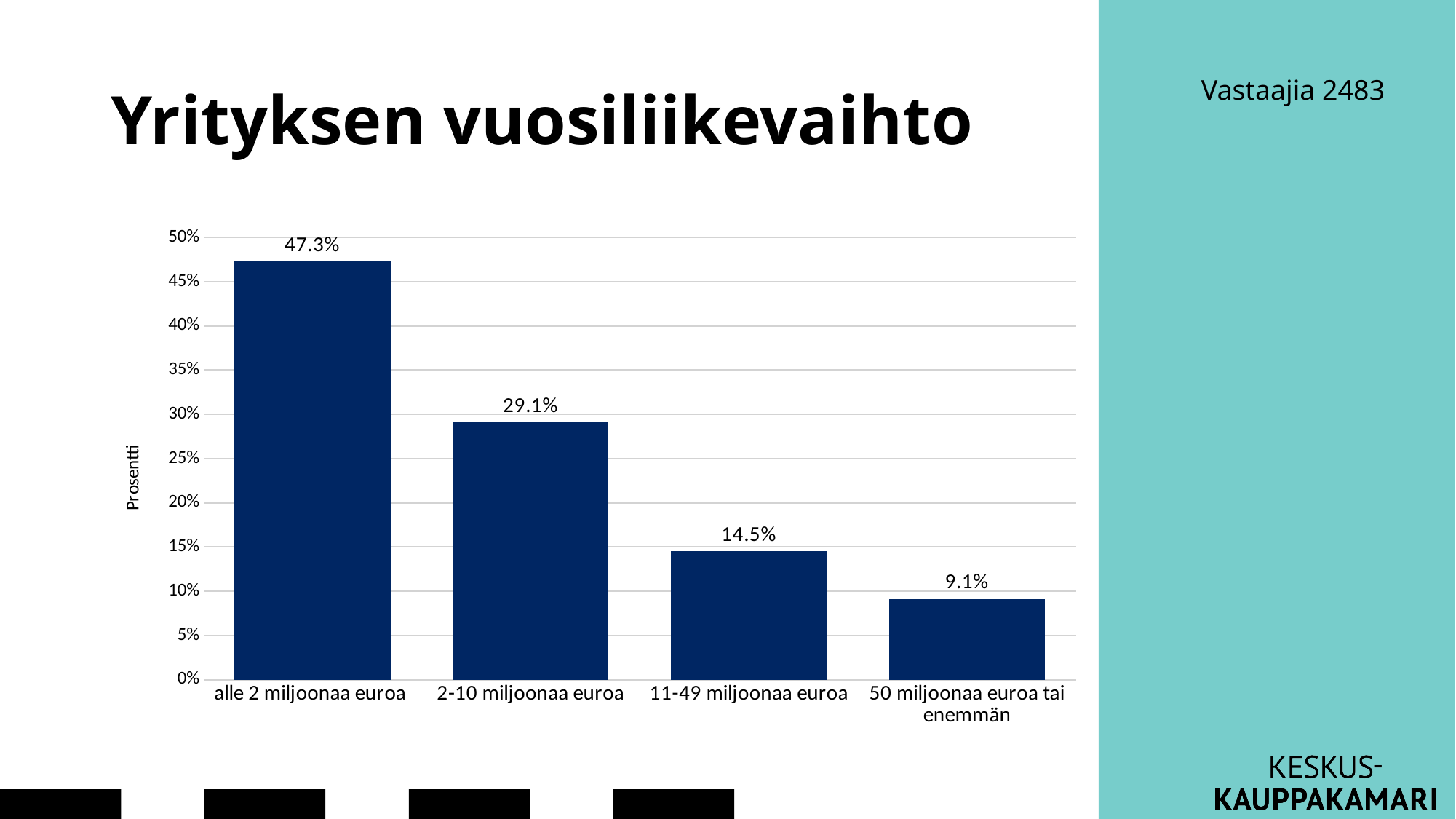
What is the value for '50 miljoonaa euroa tai enemmän'? 9.1% What is the difference between the values for 'alle 2 miljoonaa euroa' and '2-10 miljoonaa euroa'? 18.2% What is the value for '2-10 miljoonaa euroa'? 29.1% Which is larger, the value for '11-49 miljoonaa euroa' or '50 miljoonaa euroa tai enemmän'? 11-49 miljoonaa euroa Is the value for '2-10 miljoonaa euroa' greater or less than 25%? greater What kind of chart is shown on the slide? bar chart Do the values rise or fall from left to right along the x axis? fall Which category has the lowest value? 50 miljoonaa euroa tai enemmän Which category has the highest value? alle 2 miljoonaa euroa What is the value for '11-49 miljoonaa euroa'? 14.5% What is the value for 'alle 2 miljoonaa euroa'? 47.3% How many categories are shown in the chart? 4